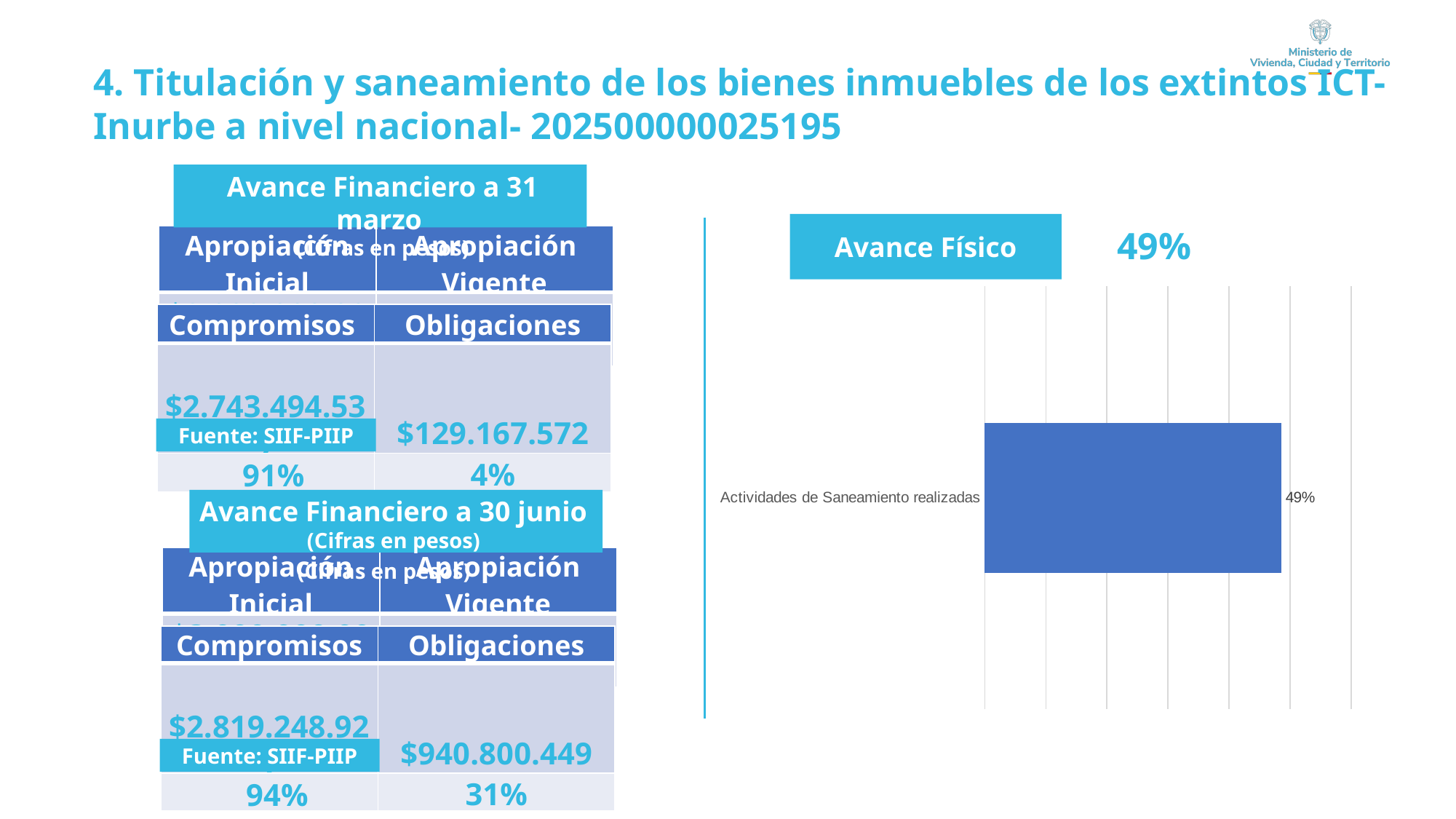
What is the title of the chart on the right side of the slide? Avance Físico What kind of chart is the Avance Físico chart? bar chart How many categories are plotted in the Avance Físico chart? 1 What is the label of the single category shown in the Avance Físico chart? Actividades de Saneamiento realizadas In the Avance Físico chart, what is the value for Actividades de Saneamiento realizadas? 49%